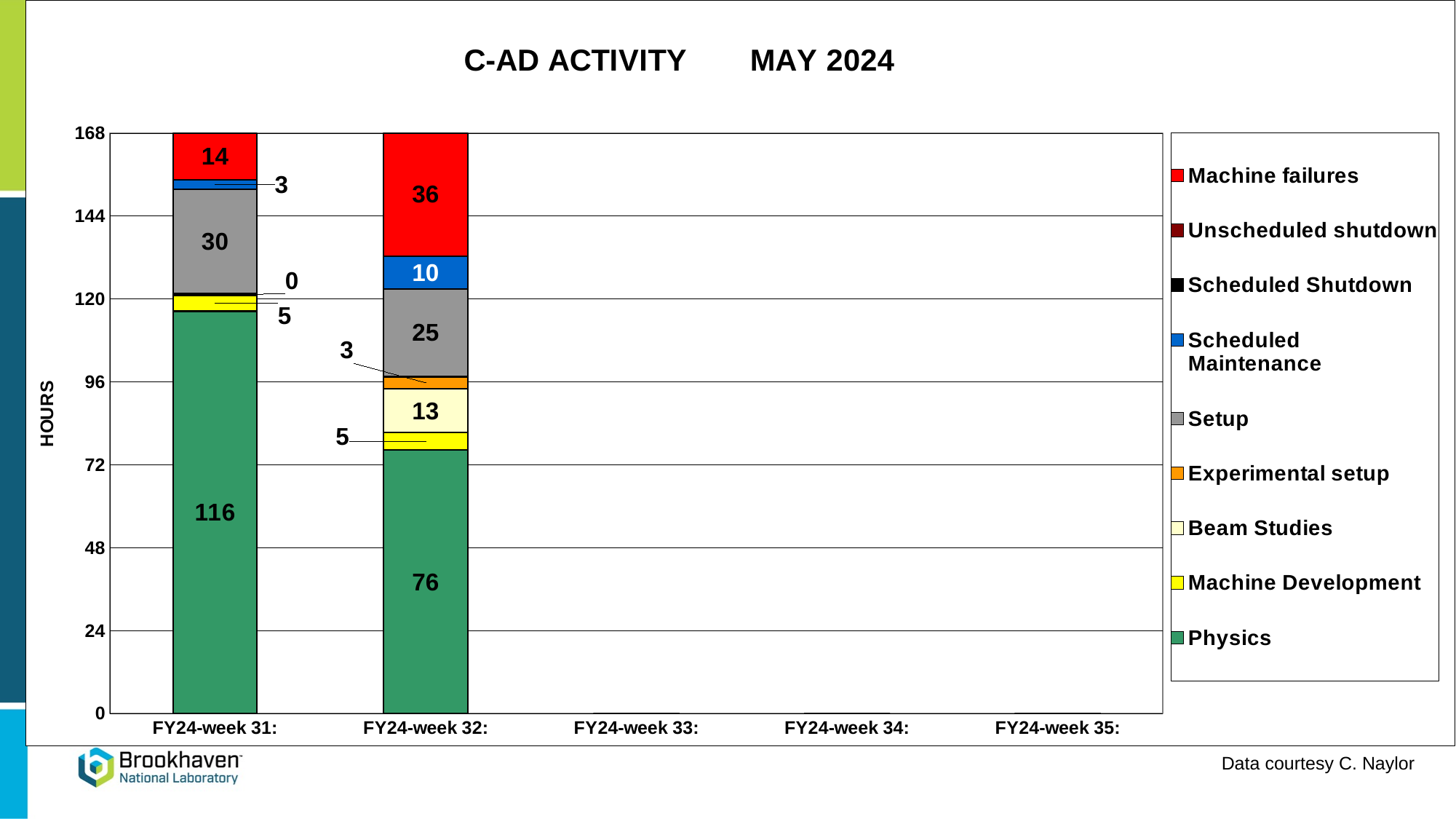
What is the total number of hours in the stacked bar for FY24-week 32? 168 How many series does the legend list? 9 How many hours of Machine failures are shown for FY24-week 32? 36 What is the label of the y axis? HOURS How many hours of Scheduled Maintenance are shown for FY24-week 31? 3 How many hours of Beam Studies are shown for FY24-week 32? 13 Which week has more Machine failures hours, FY24-week 31 or FY24-week 32? FY24-week 32 How many week categories are labelled on the x axis? 5 What kind of chart is shown on the slide? Stacked bar chart What is the difference in Physics hours between FY24-week 31 and FY24-week 32? 40 How many hours of Physics are shown for FY24-week 31? 116 How many hours of Setup are shown for FY24-week 32? 25